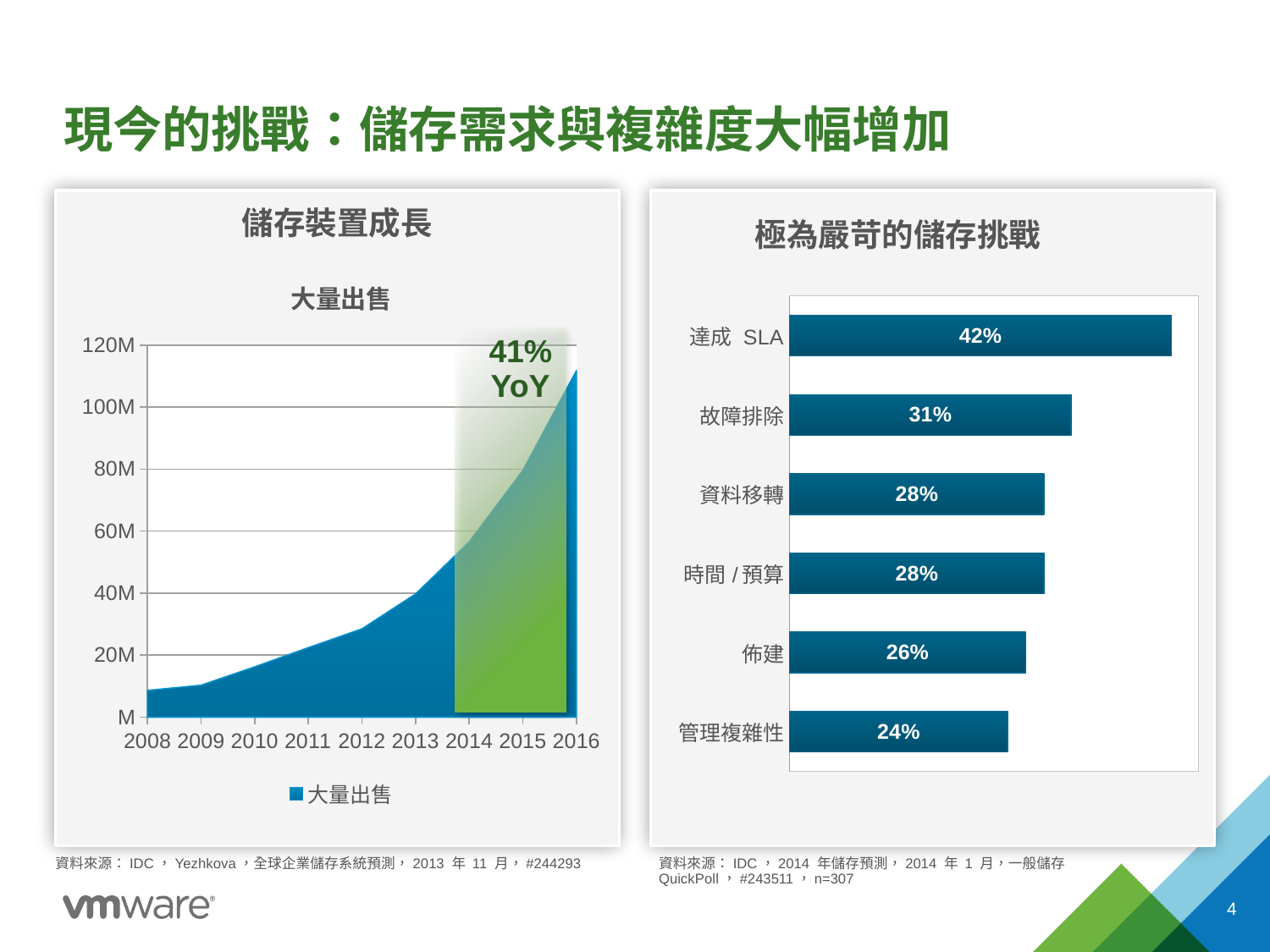
In the chart titled 極為嚴苛的儲存挑戰, what is the value for 佈建? 26% In the chart titled 儲存裝置成長, is the value for 2012 greater or less than 40M? less In the chart titled 儲存裝置成長, is the value for 2016 greater or less than 100M? greater In the chart titled 極為嚴苛的儲存挑戰, what is the value for 達成 SLA? 42% In the chart titled 儲存裝置成長, how many series does the legend list? 1 In the chart titled 極為嚴苛的儲存挑戰, which is larger, the value for 故障排除 or the value for 佈建? 故障排除 In the chart titled 極為嚴苛的儲存挑戰, how many categories are shown? 6 What kind of chart is the chart titled 極為嚴苛的儲存挑戰? Bar chart In the chart titled 儲存裝置成長, do the values rise or fall from 2008 to 2016? Rise In the chart titled 極為嚴苛的儲存挑戰, what is the difference between the values for 達成 SLA and 故障排除? 11% In the chart titled 極為嚴苛的儲存挑戰, which category has the lowest value? 管理複雜性 In the chart titled 極為嚴苛的儲存挑戰, which category has the highest value? 達成 SLA